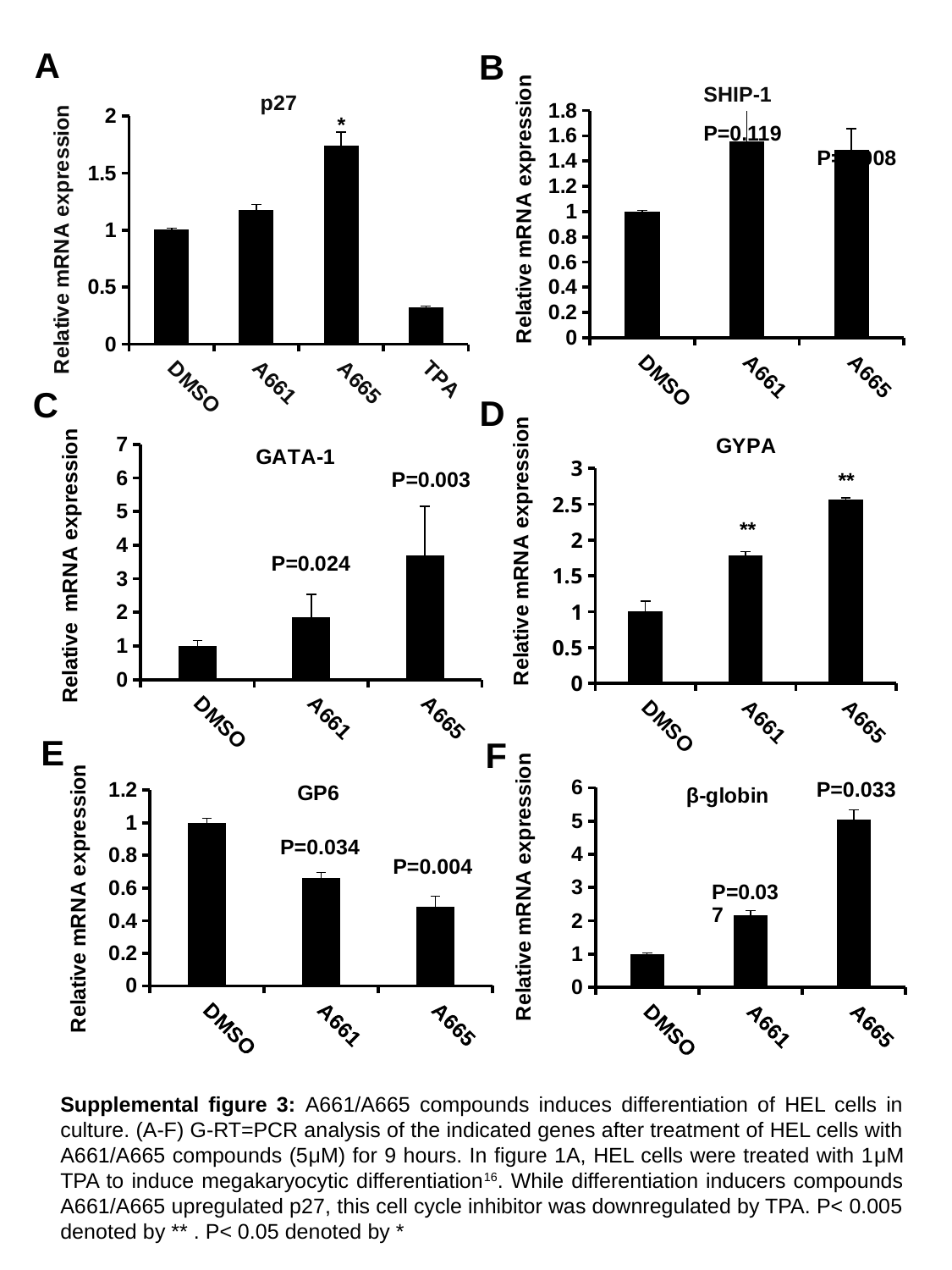
In the GYPA chart (panel D), is the value for A661 greater or less than 1.5? greater In the GATA-1 chart (panel C), which category has the highest relative mRNA expression? A665 In the GP6 chart (panel E), do the values rise or fall from DMSO to A665? fall In the p27 chart (panel A), which category has the highest relative mRNA expression? A665 What kind of chart is used in panel F (β-globin)? bar chart In the β-globin chart (panel F), is the value for A665 greater or less than 4? greater In the p27 chart (panel A), is the value for TPA greater or less than 0.5? less In the GATA-1 chart (panel C), what P value is printed above the A665 bar? P=0.003 In the p27 chart (panel A), how many categories are shown on the x axis? 4 In the GP6 chart (panel E), which is larger, the value for DMSO or the value for A665? DMSO In the p27 chart (panel A), which category has the lowest relative mRNA expression? TPA